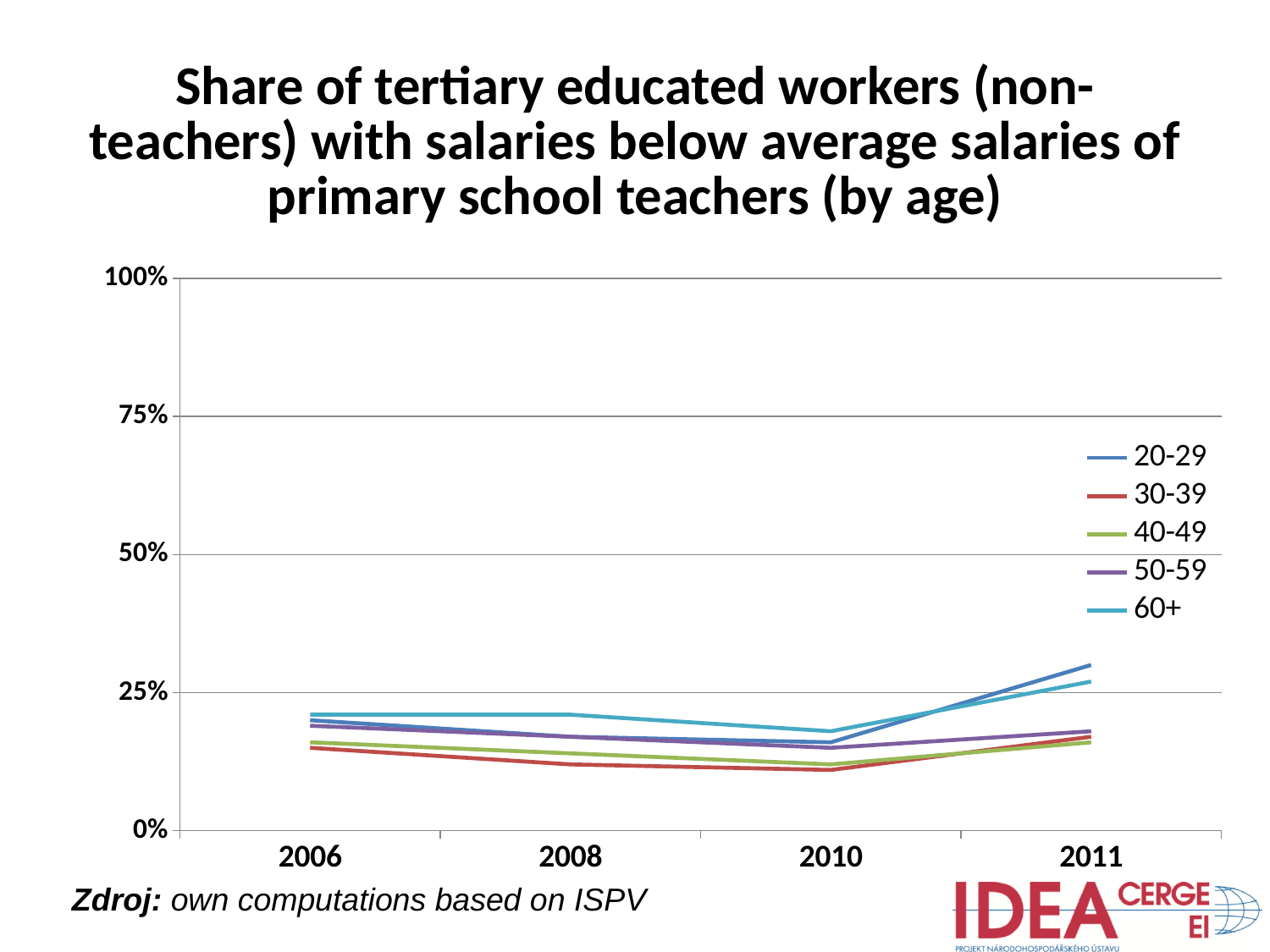
Is the value for the 30-39 group in 2010 greater or less than 25%? less How many years are shown on the x axis? 4 How many series does the legend list? 5 Does the value for the 30-39 group rise or fall from 2006 to 2010? fall Is the value for the 60+ group in 2006 greater or less than 50%? less Does the value for the 20-29 group rise or fall from 2010 to 2011? rise Which is larger in 2011, the value for 20-29 or the value for 30-39? 20-29 What kind of chart is shown on the slide? line chart Is the value for the 20-29 group in 2011 greater or less than 25%? greater Which age groups are listed in the legend? 20-29, 30-39, 40-49, 50-59, 60+ Which is larger in 2006, the value for 60+ or the value for 40-49? 60+ Which age group has the highest value in 2011? 20-29